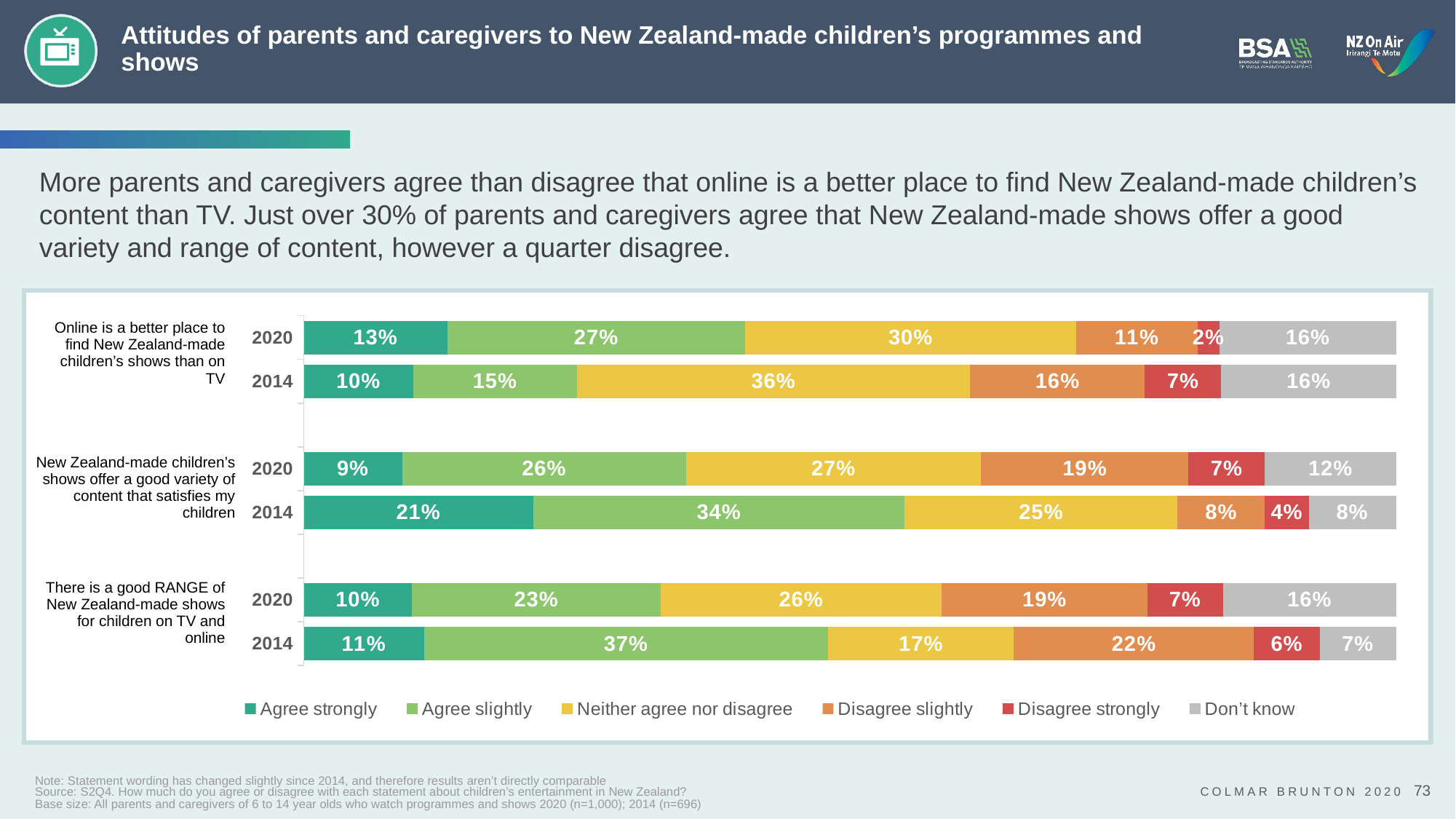
What is the combined share of 'Agree strongly' and 'Agree slightly' in 2020 for the statement that there is a good RANGE of New Zealand-made shows for children on TV and online? 33% What percentage of parents and caregivers agreed strongly in 2020 that online is a better place to find New Zealand-made children's shows than on TV? 13% In 2014, what share neither agreed nor disagreed that online is a better place to find New Zealand-made children's shows than on TV? 36% How many response categories does the legend list? 6 For the statement about a good RANGE of New Zealand-made shows, was 'Disagree slightly' higher in 2014 or 2020? 2014 What is the 'Don't know' value for 2020 on the statement that New Zealand-made children's shows offer a good variety of content that satisfies my children? 12% Which response category is the smallest segment in the 2020 bar for 'Online is a better place to find New Zealand-made children's shows than on TV'? Disagree strongly (2%) What type of chart is shown on the slide? Stacked bar chart Which bar has the largest 'Agree strongly' segment? New Zealand-made children's shows offer a good variety of content, 2014 (21%) How many statements are shown in the chart? 3 What percentage agreed slightly in 2014 that there is a good RANGE of New Zealand-made shows for children on TV and online? 37% By how many percentage points did 'Agree strongly' fall from 2014 to 2020 for the statement about New Zealand-made children's shows offering a good variety of content? 12 percentage points